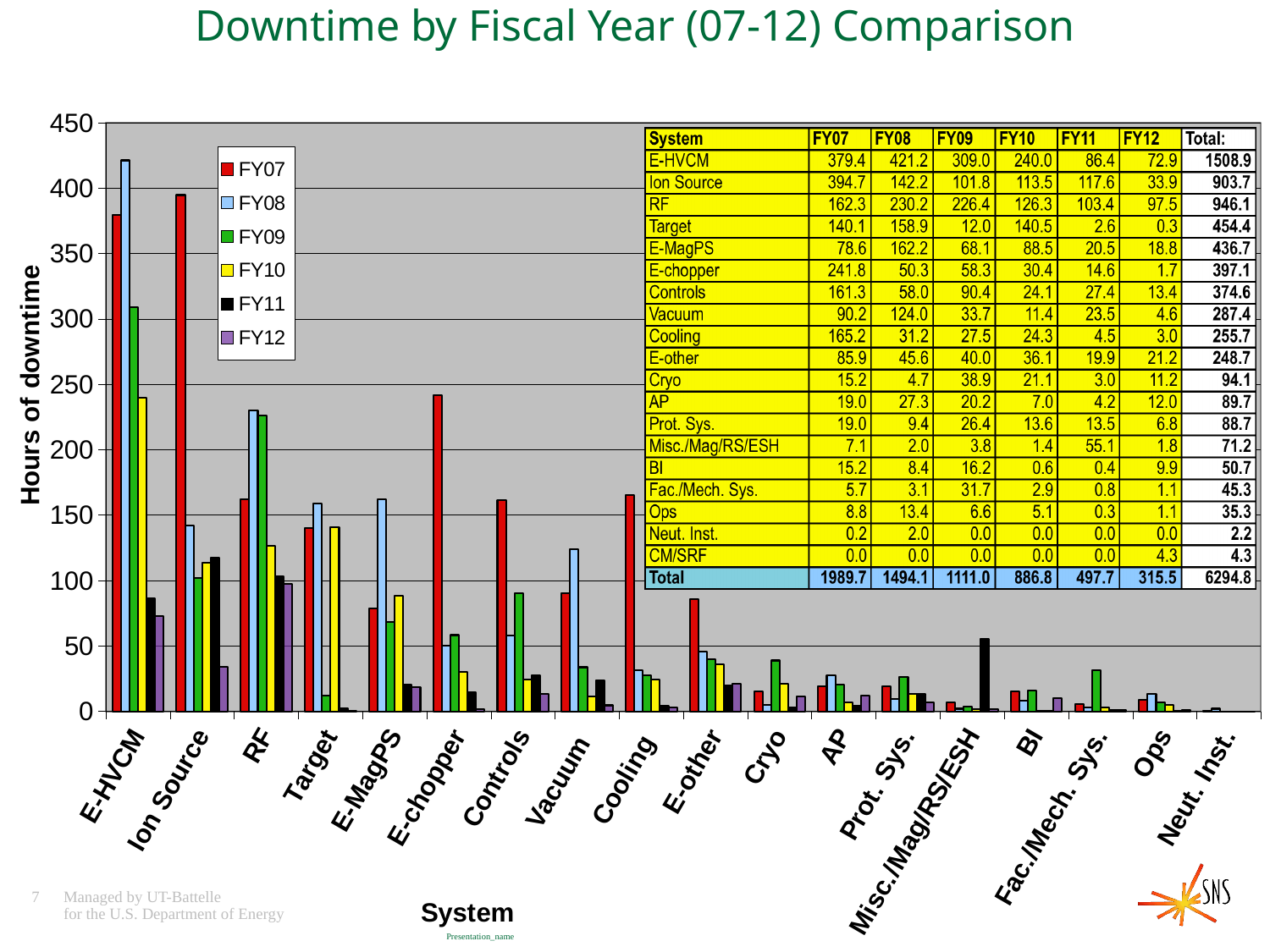
Which is larger for FY08: E-MagPS or E-chopper? E-MagPS What is the FY09 downtime value for Target? 12.0 What kind of chart is shown on the slide? bar chart Is the FY07 value for Ion Source greater or less than 350? greater What is the FY07 downtime value for E-chopper? 241.8 Which system has the highest FY08 downtime? E-HVCM Which system has the highest FY07 downtime? Ion Source Do the Cooling downtime values rise or fall from FY07 to FY12? fall How many system categories are labelled along the x axis of the chart? 18 What is the FY08 downtime value for E-HVCM? 421.2 How many fiscal-year series does the legend list? 6 What is the difference between the FY08 and FY07 downtime values for E-HVCM? 41.8